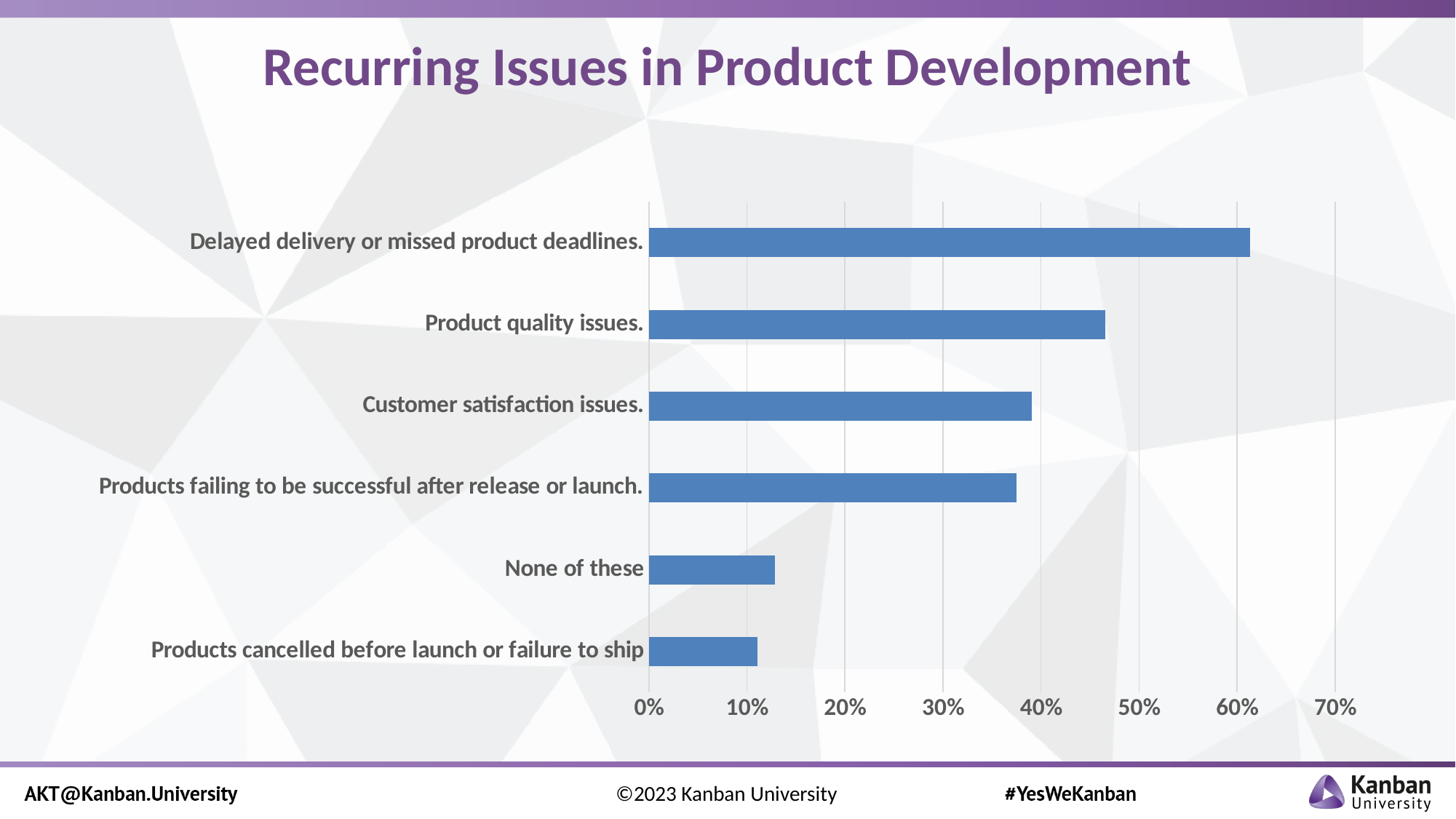
What kind of chart is shown on the slide? bar chart How many categories are plotted in the chart? 6 Is the value for Products cancelled before launch or failure to ship greater or less than 20%? less Which is larger, the value for None of these or the value for Products failing to be successful after release or launch? Products failing to be successful after release or launch. Which is larger, the value for Product quality issues or the value for Customer satisfaction issues? Product quality issues. What is the highest value shown on the horizontal axis? 70% Is the value for Product quality issues greater or less than 50%? less Which category has the highest value? Delayed delivery or missed product deadlines. Is the value for Delayed delivery or missed product deadlines greater or less than 50%? greater What is the title of the chart? Recurring Issues in Product Development